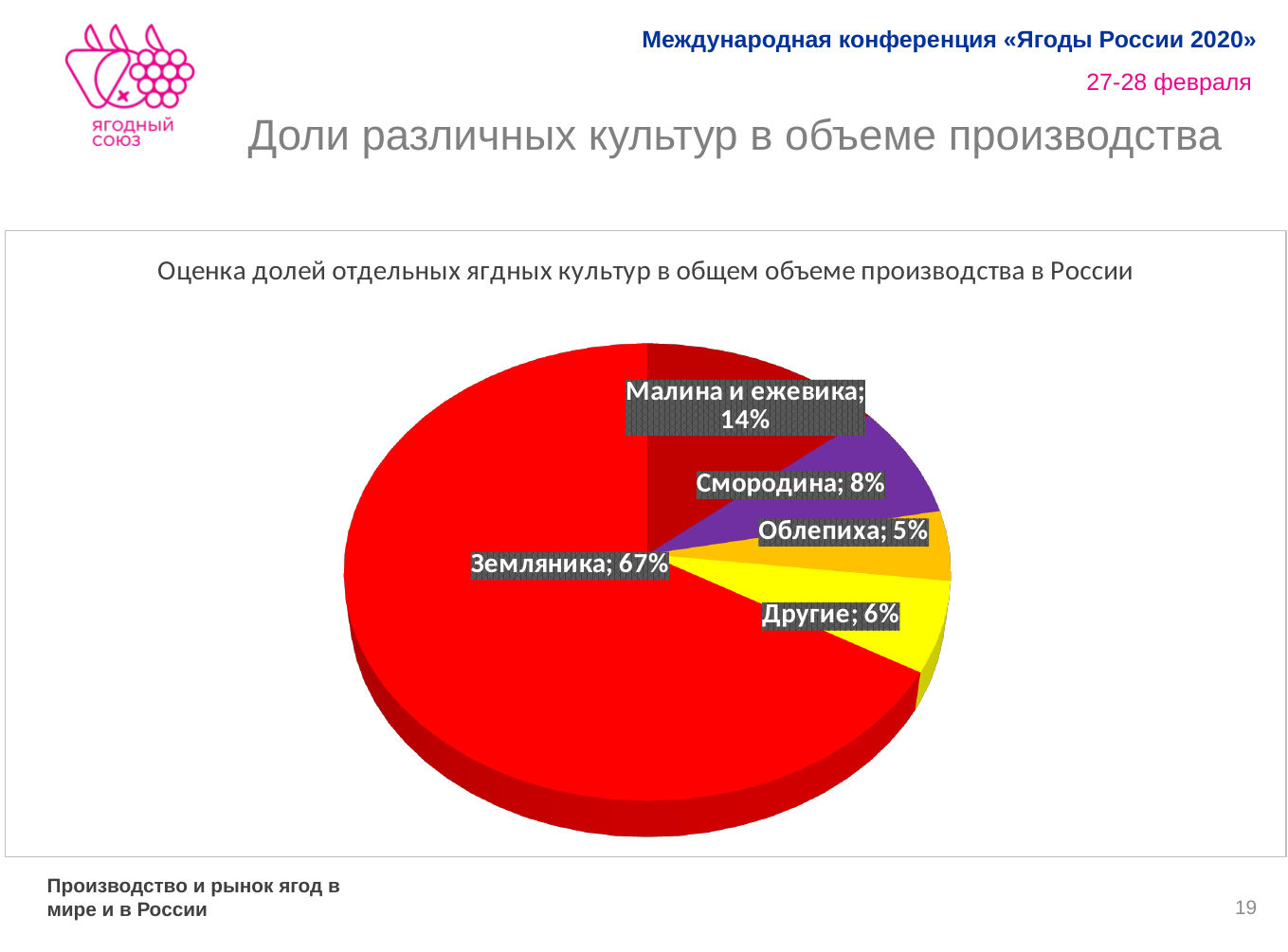
What is the share of Малина и ежевика in the pie chart? 14% How many slices does the pie chart have? 5 What type of chart is shown on the slide? Pie chart What is the share of Земляника in the pie chart? 67% What is the title of the chart? Оценка долей отдельных ягдных культур в общем объеме производства в России Which category has the smallest share in the pie chart? Облепиха What is the difference in percentage points between Земляника and Малина и ежевика? 53 What is the share of Смородина in the pie chart? 8% Which has a larger share, Смородина or Другие? Смородина Which category has the largest share in the pie chart? Земляника What is the share of Другие in the pie chart? 6% What is the share of Облепиха in the pie chart? 5%